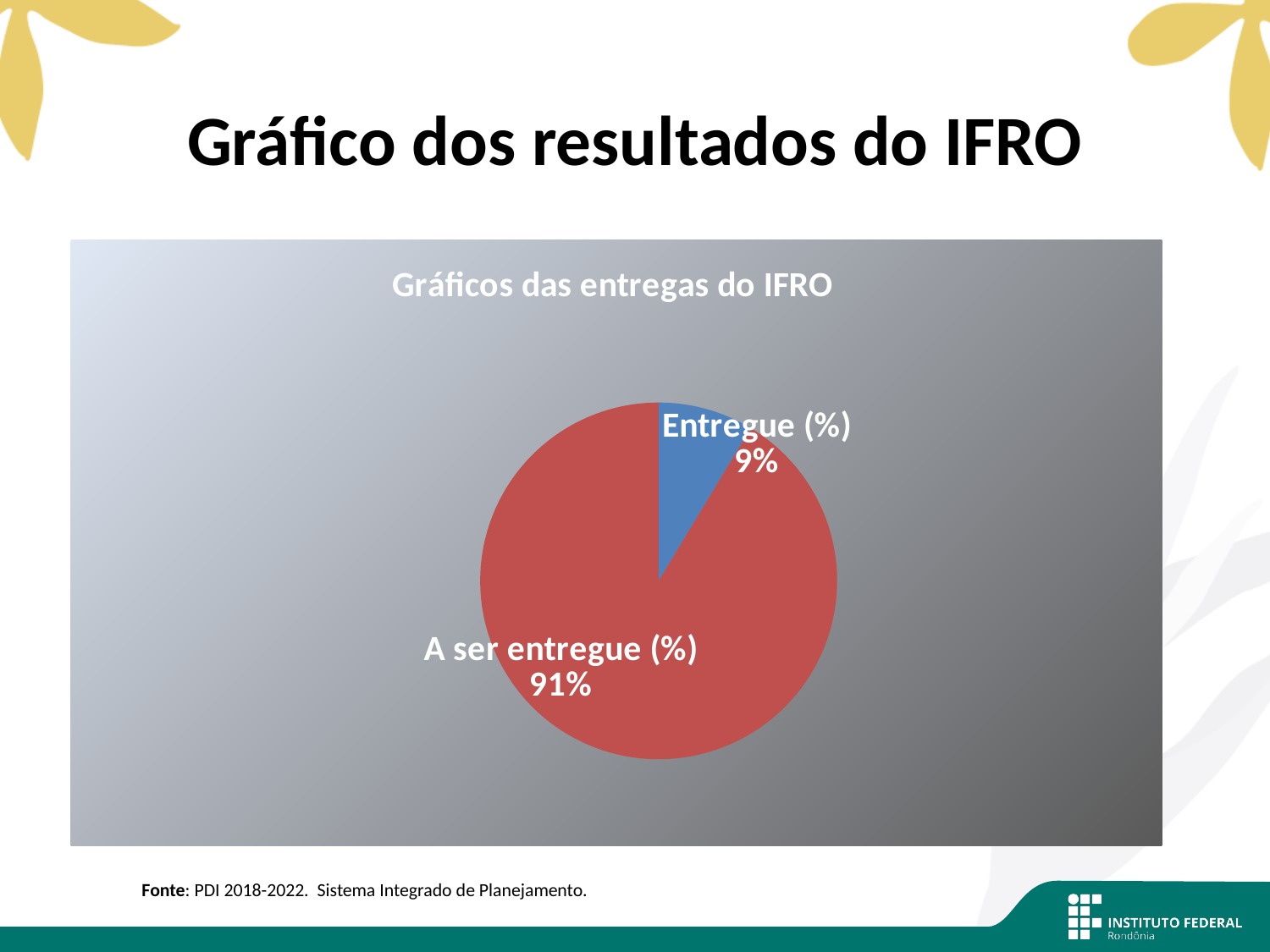
Which slice of the pie is the largest? A ser entregue (%) How many slices does the pie chart have? 2 What is the chart's title? Gráficos das entregas do IFRO What colour is the "Entregue (%)" slice? blue What kind of chart is shown on the slide? pie chart Which is larger, the "Entregue (%)" slice or the "A ser entregue (%)" slice? A ser entregue (%) What share of the pie does "A ser entregue (%)" represent? 91% What percentage is shown for "A ser entregue (%)"? 91% What percentage is shown for "Entregue (%)"? 9% Which slice of the pie is the smallest? Entregue (%) What is the difference in percentage points between "A ser entregue (%)" and "Entregue (%)"? 82